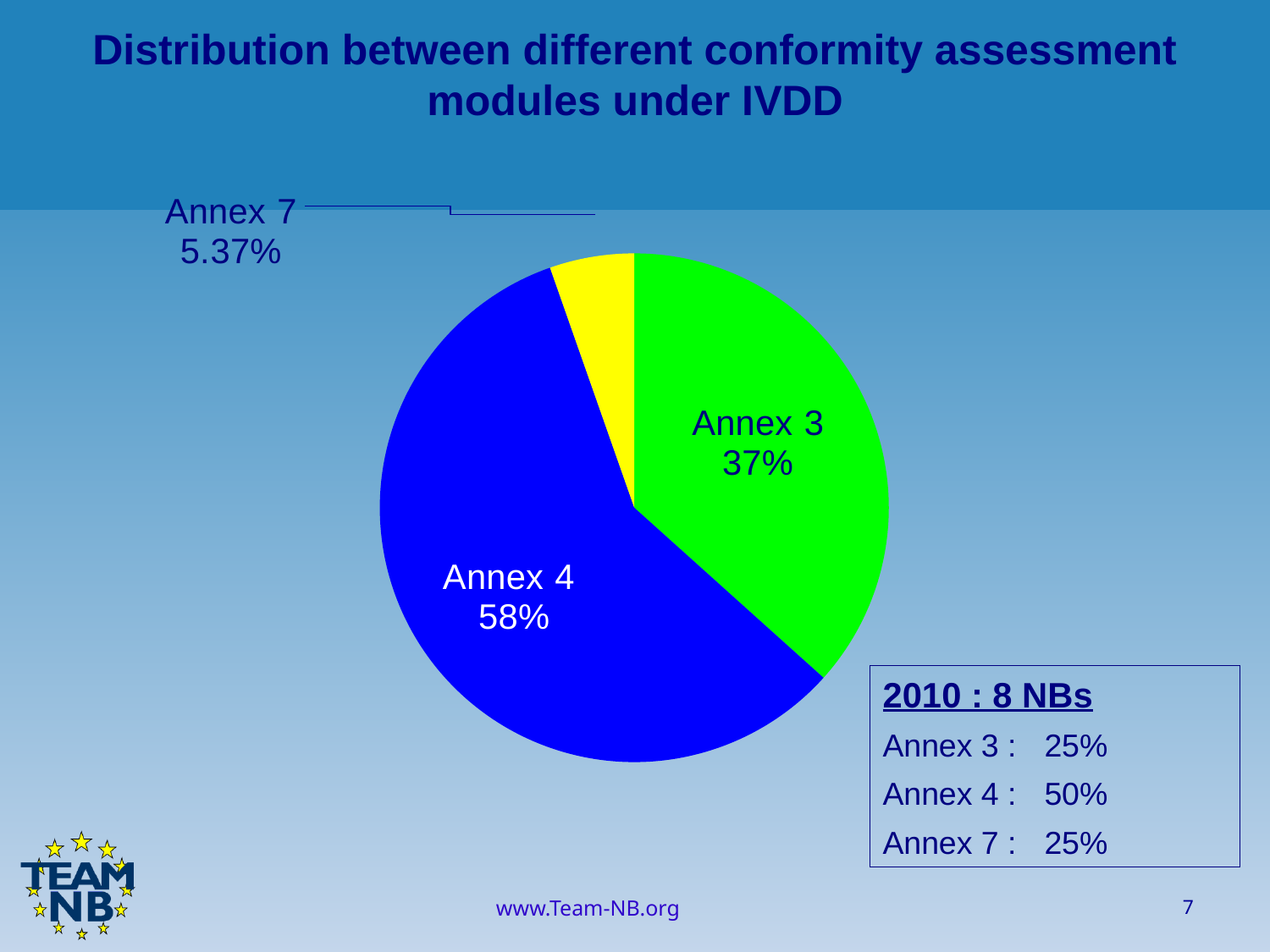
How many slices does the pie chart have? 3 Which is larger, the slice for Annex 3 or the slice for Annex 4? Annex 4 What share of the pie does Annex 3 represent? 37% Which annex has the largest slice of the pie? Annex 4 Which annex has the smallest slice of the pie? Annex 7 What kind of chart is shown on the slide? pie chart What colour is the Annex 4 slice? blue What is the difference in percentage points between the Annex 4 slice and the Annex 3 slice? 21 What colour is the Annex 7 slice? yellow What share of the pie does Annex 7 represent? 5.37% Is the share for Annex 3 greater or less than 50%? less What share of the pie does Annex 4 represent? 58%